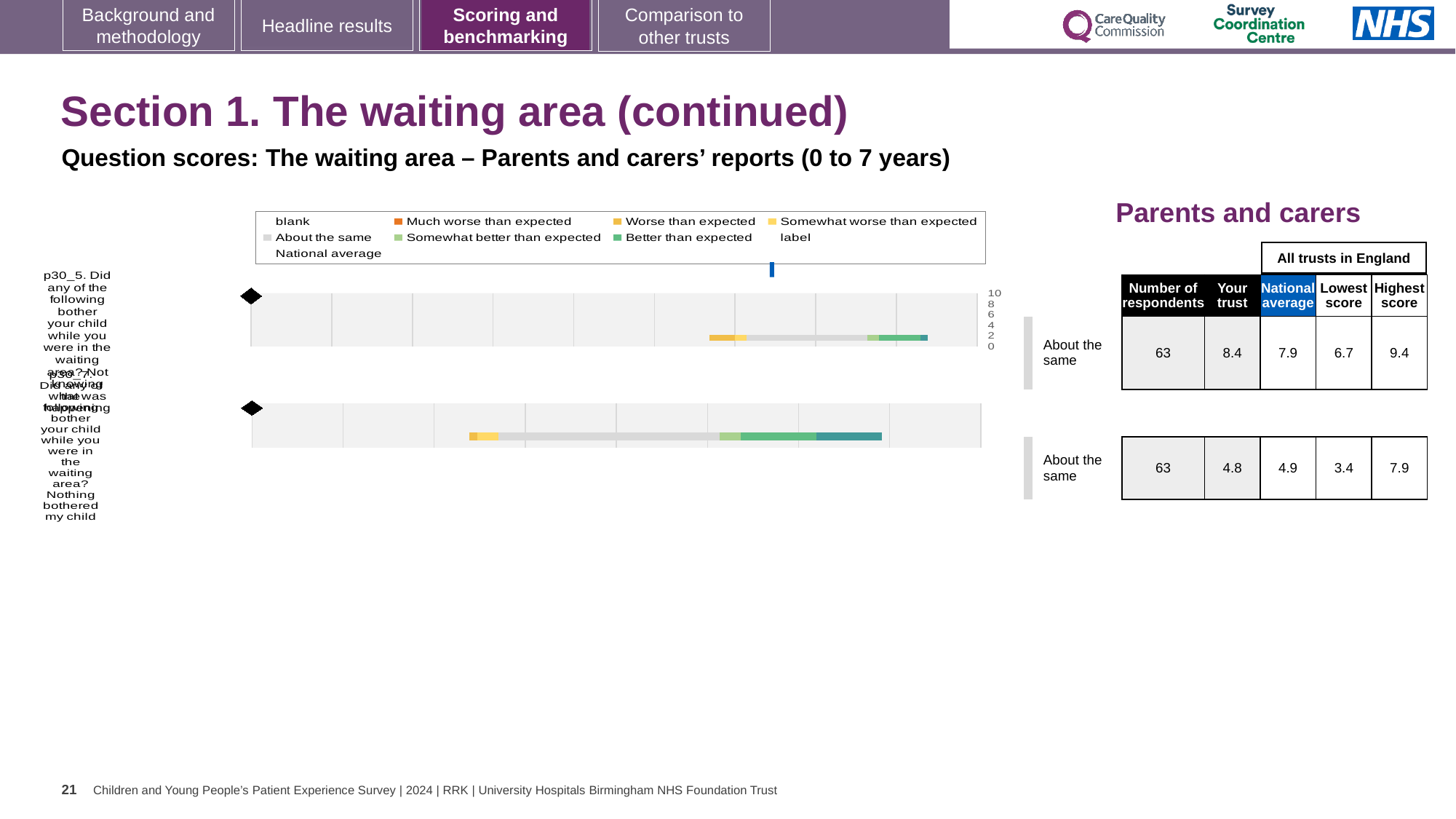
What is the 'Your trust' score for question p30_7 (Nothing bothered my child)? 4.8 What benchmark category is shown next to the bar for question p30_5? About the same How many question bars are plotted in the chart? 2 What is the highest score among all trusts in England for question p30_7? 7.9 What kind of chart is shown on the slide? bar chart What is the difference between the 'Your trust' score and the national average for question p30_5? 0.5 Which legend entry in the chart is shown in light grey? About the same How many respondents are reported for question p30_5? 63 Which legend entry in the chart is shown in orange? Much worse than expected What is the 'Your trust' score for question p30_5 (Not knowing what was happening)? 8.4 For question p30_5, which is larger: the 'Your trust' score or the national average? Your trust What is the national average score for question p30_7? 4.9